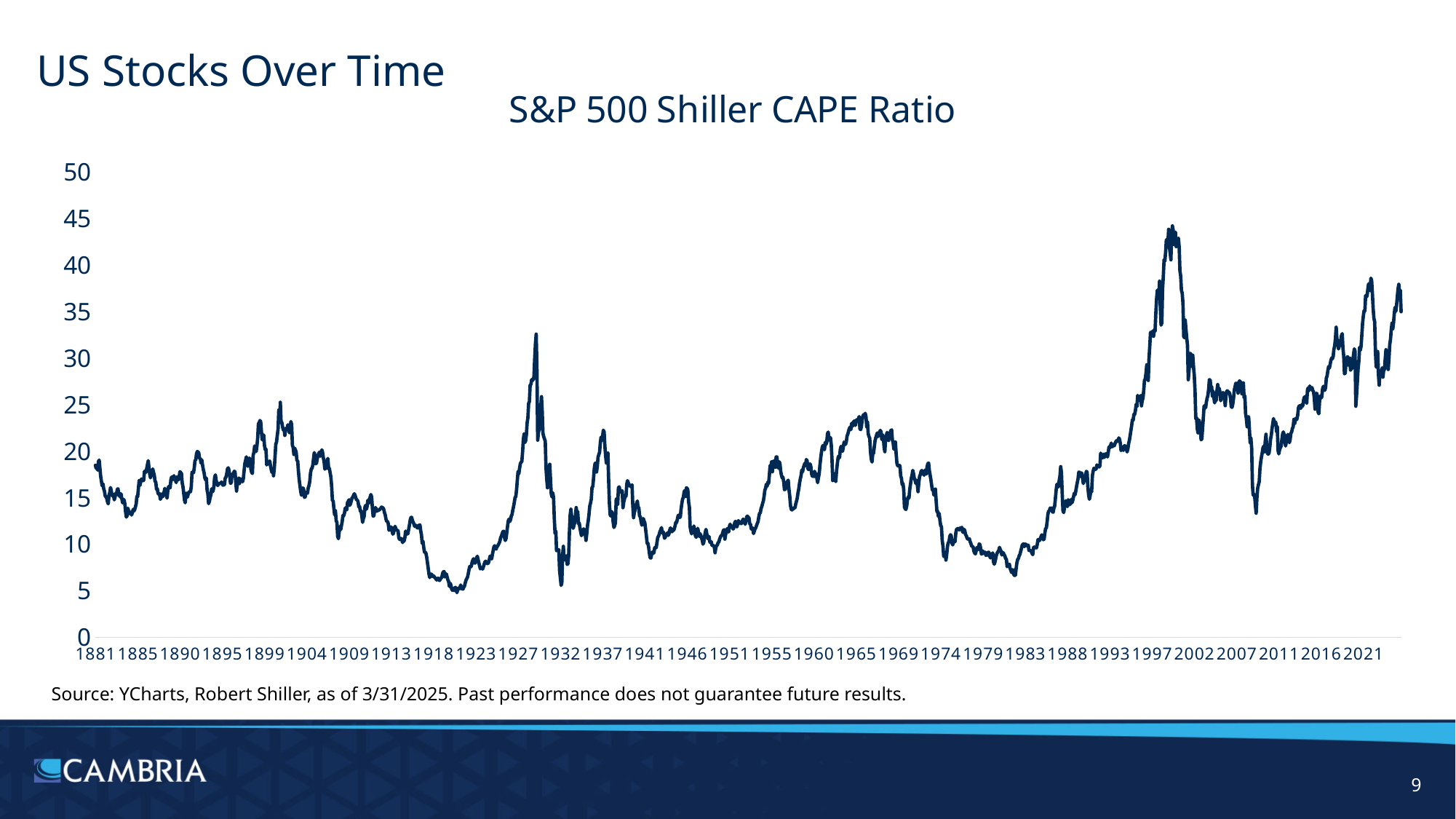
How many data series are plotted in the chart? 1 What is the highest value shown on the vertical axis? 50 Does the CAPE ratio generally rise or fall between 1983 and 2000? rise Is the CAPE ratio at its low point around 1982 greater or less than 10? less What kind of chart is shown on the slide? Line chart Is the highest peak in the chart near 2000 or near 1929? near 2000 Is the CAPE ratio at its low point around 1920 greater or less than 10? less Is the CAPE ratio at the start of the chart in 1881 greater or less than 15? greater What is the title of the chart? S&P 500 Shiller CAPE Ratio How many year labels are shown on the horizontal axis? 31